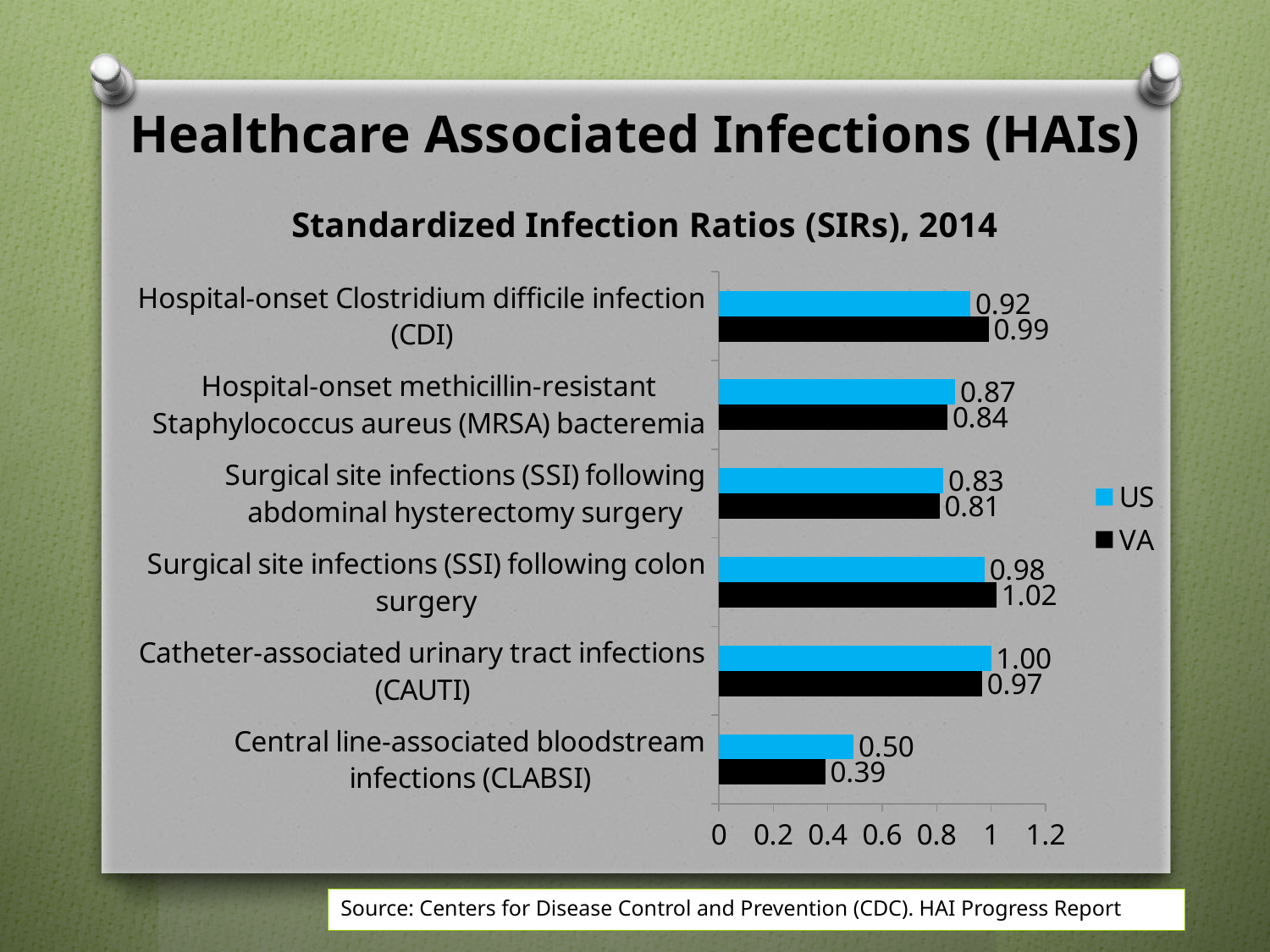
What is the US value for Central line-associated bloodstream infections (CLABSI)? 0.50 Is the VA value for Surgical site infections (SSI) following colon surgery greater or less than 1? greater What is the VA value for Hospital-onset Clostridium difficile infection (CDI)? 0.99 What is the VA value for Surgical site infections (SSI) following colon surgery? 1.02 What is the difference between the US and VA values for Central line-associated bloodstream infections (CLABSI)? 0.11 What kind of chart is shown on the slide? Bar chart Which category has the highest US value? Catheter-associated urinary tract infections (CAUTI) Which category has the lowest VA value? Central line-associated bloodstream infections (CLABSI) Which is larger for Hospital-onset Clostridium difficile infection (CDI), the US value or the VA value? VA What is the title of the chart? Standardized Infection Ratios (SIRs), 2014 How many infection categories are shown in the chart? 6 How many series does the legend list? 2